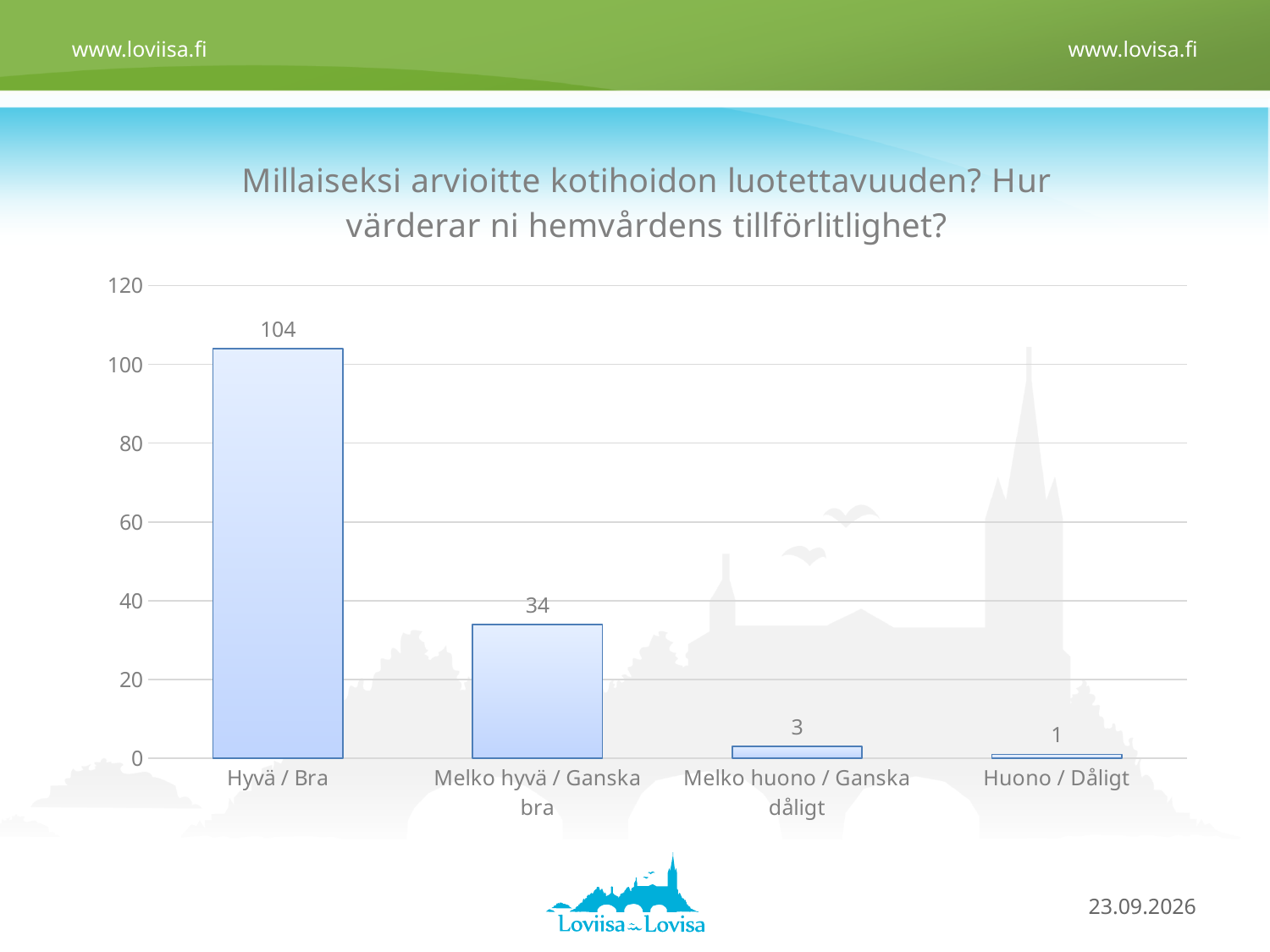
How many categories are shown on the x axis? 4 What is the value for Huono / Dåligt? 1 Which is larger, the value for Melko huono / Ganska dåligt or the value for Huono / Dåligt? Melko huono / Ganska dåligt What is the value for Melko hyvä / Ganska bra? 34 Which category has the highest value? Hyvä / Bra Which category has the lowest value? Huono / Dåligt What is the value for Melko huono / Ganska dåligt? 3 What kind of chart is shown on the slide? bar chart What is the difference between the values for Hyvä / Bra and Melko hyvä / Ganska bra? 70 Is the value for Hyvä / Bra greater or less than 100? greater Do the values rise or fall from left to right along the x axis? fall What is the value for Hyvä / Bra? 104